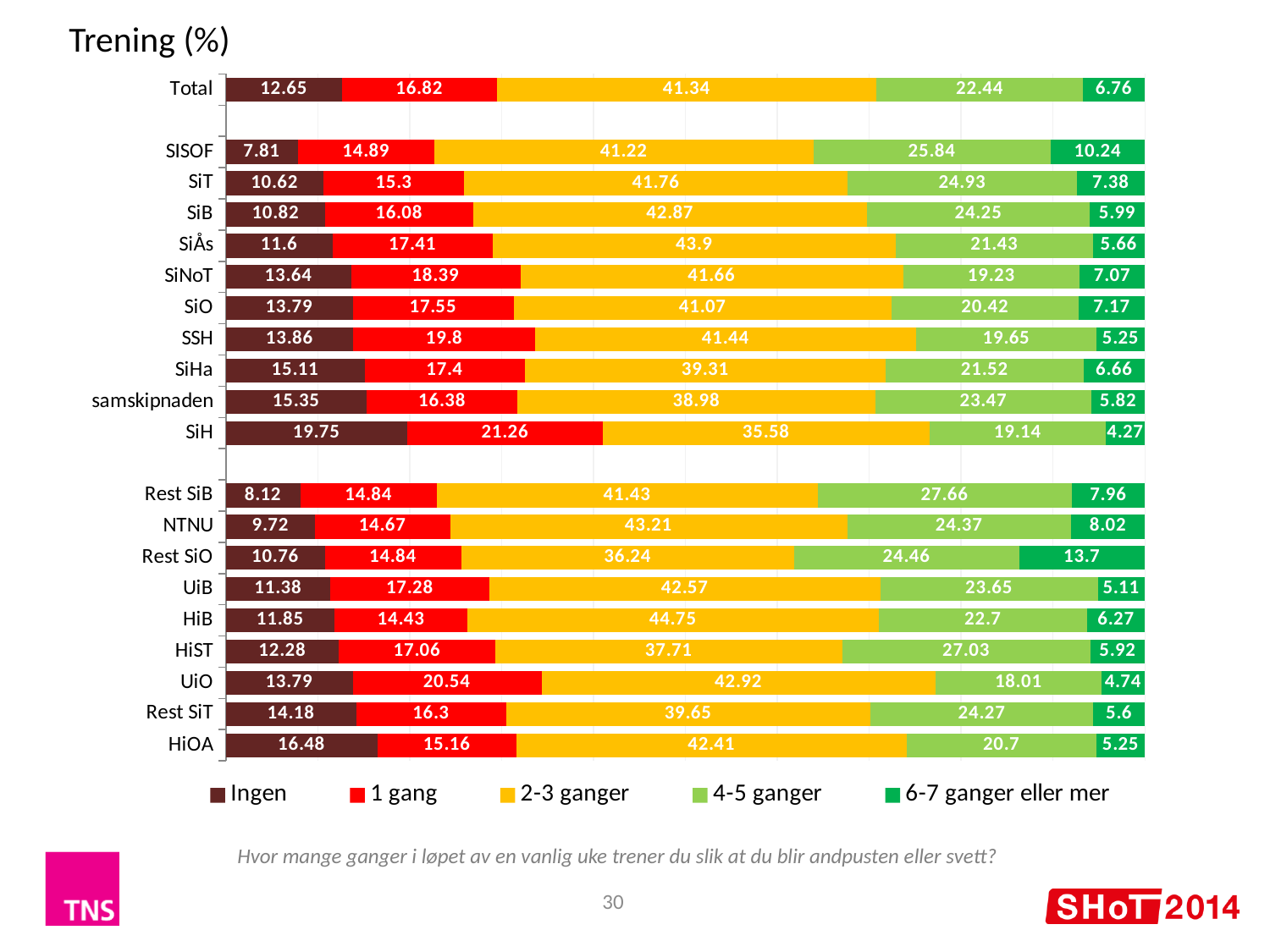
What is the total of the stacked bar for SISOF? 100 What is the difference between the "2-3 ganger" and "4-5 ganger" values for Total? 18.9 What is the value of the "Ingen" segment for Total? 12.65 How many series does the legend list? 5 Which category has the lowest "Ingen" value? SISOF What is the value of the "1 gang" segment for SiH? 21.26 How many categories (bars) are shown in the chart? 20 Which has the larger "1 gang" value, UiO or HiOA? UiO What is the value of the "6-7 ganger eller mer" segment for Rest SiO? 13.7 What kind of chart is shown on the slide? Stacked bar chart What is the value of the "2-3 ganger" segment for HiB? 44.75 Which category has the highest "Ingen" value? SiH